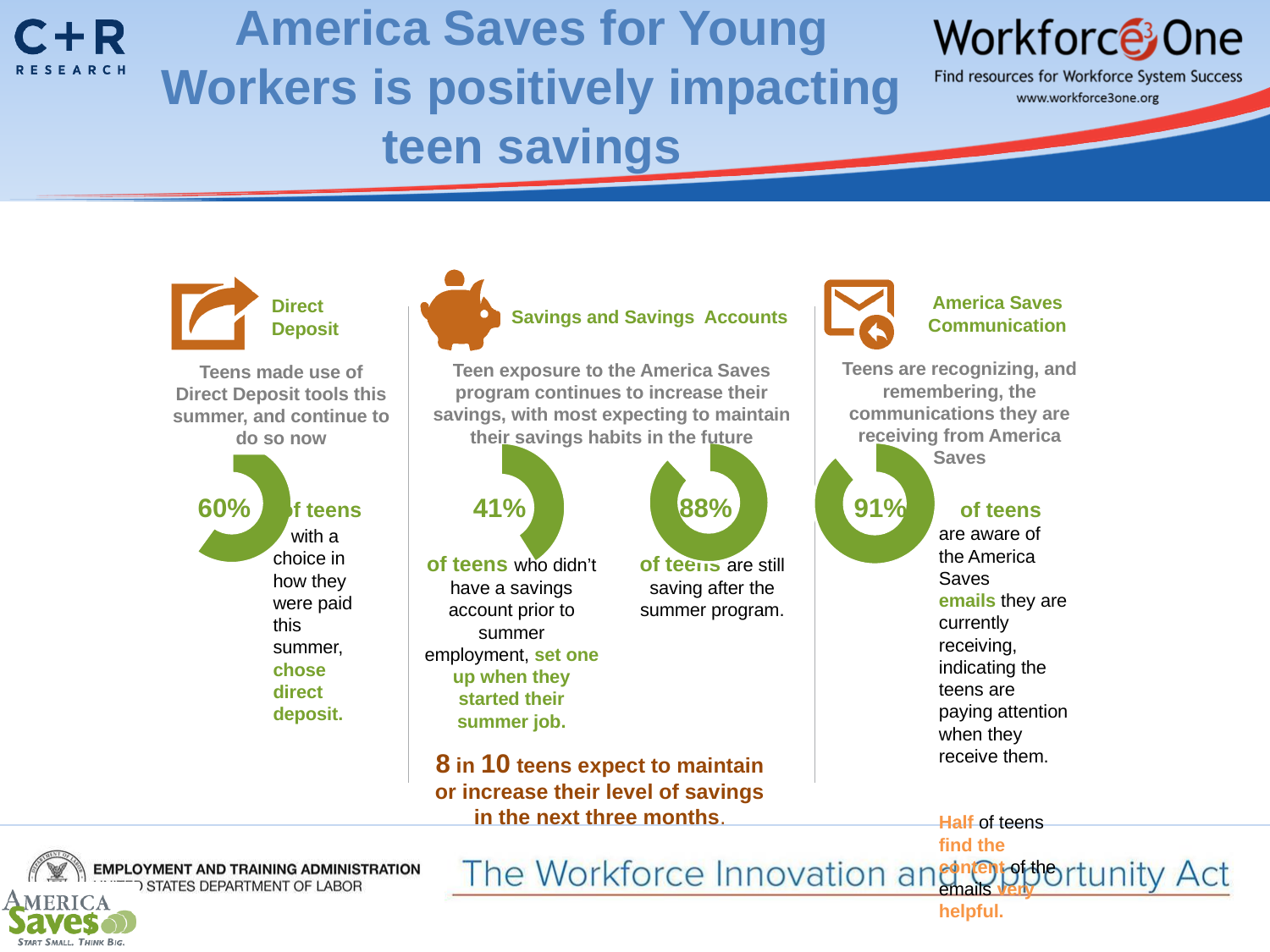
How many donut charts are shown on the slide? 4 What is the difference between the percentage of teens aware of the America Saves emails (91%) and the percentage who chose direct deposit (60%)? 31% Which of the four donut charts on the slide shows the lowest percentage? 41% What colour is the filled portion of the donut charts on the slide? Green What kind of chart is used to display the percentages on this slide? Donut chart In the Savings and Savings Accounts section, what percentage of teens who didn't have a savings account prior to summer employment set one up when they started their summer job? 41% In the Savings and Savings Accounts section, what percentage of teens are still saving after the summer program? 88% Which of the four donut charts on the slide shows the highest percentage? 91% In the America Saves Communication section, what percentage of teens are aware of the America Saves emails they are currently receiving? 91% Which is larger: the percentage of teens who chose direct deposit or the percentage of teens aware of the America Saves emails? Teens aware of the America Saves emails (91%) In the Direct Deposit section, what percentage of teens with a choice in how they were paid chose direct deposit? 60% What is the difference between the percentage of teens still saving after the summer program (88%) and the percentage who set up a savings account when they started their summer job (41%)? 47%